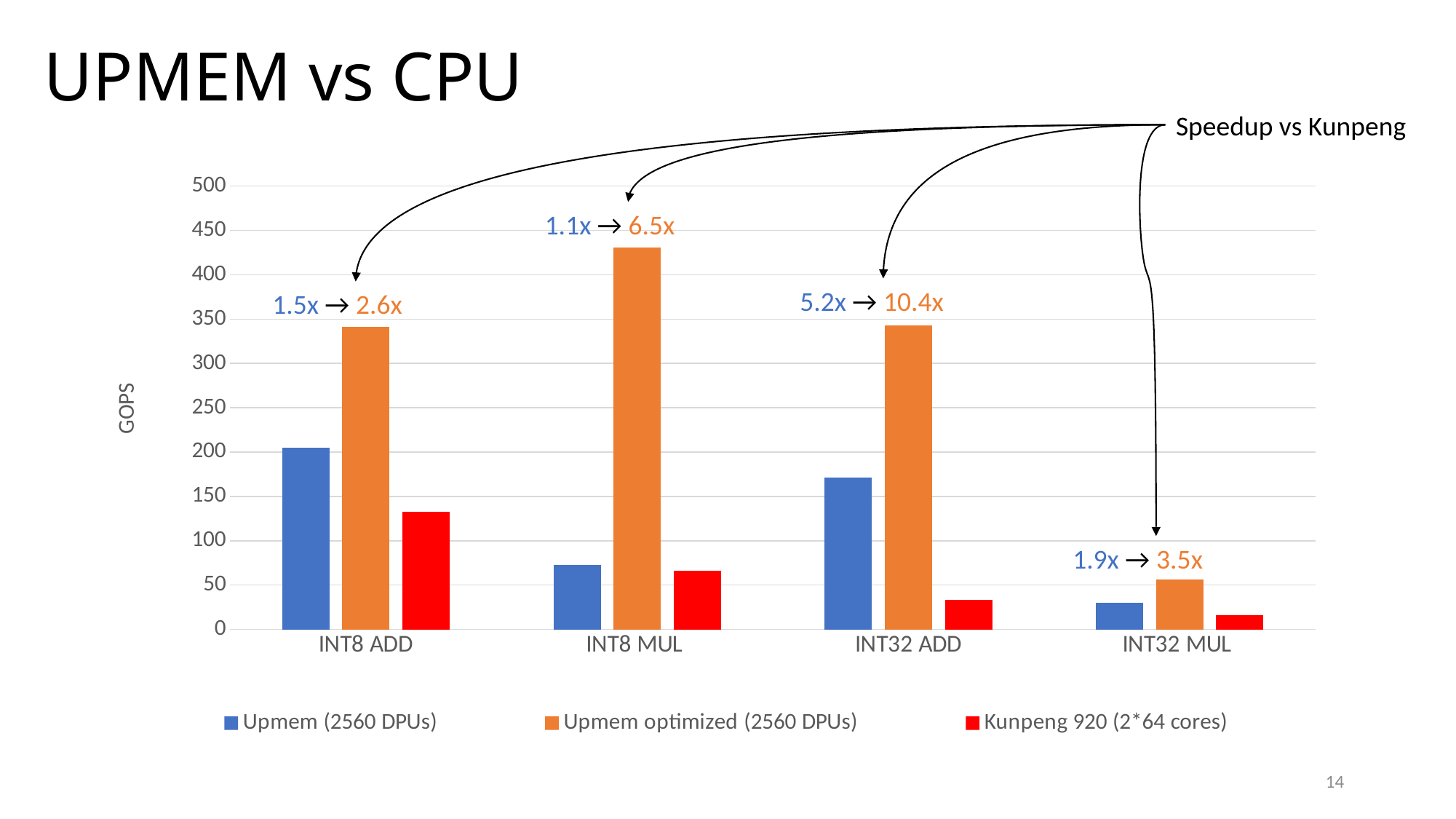
Which is larger: the Upmem (2560 DPUs) bar for INT32 ADD or the Upmem (2560 DPUs) bar for INT8 MUL? INT32 ADD Is the Upmem optimized (2560 DPUs) value for INT8 MUL greater or less than 400? greater For INT8 ADD, which is larger: the Upmem (2560 DPUs) bar or the Kunpeng 920 (2*64 cores) bar? Upmem (2560 DPUs) Is the Kunpeng 920 (2*64 cores) value for INT32 ADD greater or less than 50? less Which category has the lowest Kunpeng 920 (2*64 cores) bar? INT32 MUL Which category has the highest Upmem (2560 DPUs) bar? INT8 ADD What kind of chart is shown on the slide? bar chart What speedup annotation is shown above the INT32 ADD bars? 5.2x → 10.4x How many series does the legend list? 3 Which category has the highest Upmem optimized (2560 DPUs) bar? INT8 MUL What is the label on the y axis? GOPS How many categories are shown on the x axis? 4